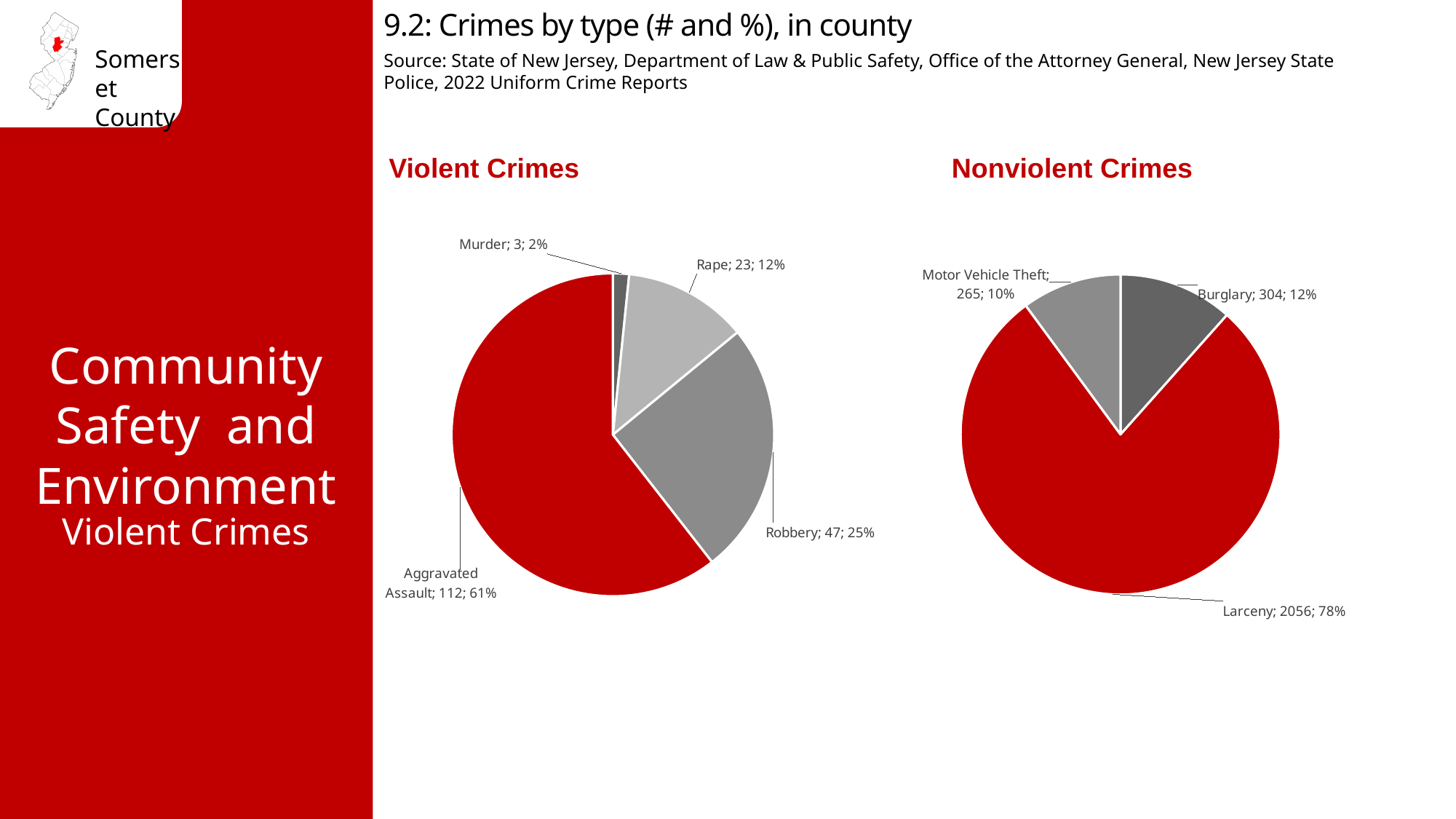
In the Violent Crimes chart, which category has the largest slice? Aggravated Assault In the Violent Crimes chart, what is the difference between the number of robberies and the number of rapes? 24 What type of chart is used for Nonviolent Crimes? Pie chart How many categories does the Violent Crimes pie chart show? 4 In the Nonviolent Crimes chart, how many larcenies are shown? 2056 In the Violent Crimes chart, what percentage share does Robbery have? 25% In the Violent Crimes chart, which category has the smallest slice? Murder In the Nonviolent Crimes chart, which is larger, Burglary or Motor Vehicle Theft? Burglary In the Nonviolent Crimes chart, what colour is the Larceny slice? Red In the Nonviolent Crimes chart, what is the difference between the number of burglaries and motor vehicle thefts? 39 In the Nonviolent Crimes chart, what percentage share does Motor Vehicle Theft have? 10% In the Violent Crimes chart, how many aggravated assaults are shown? 112